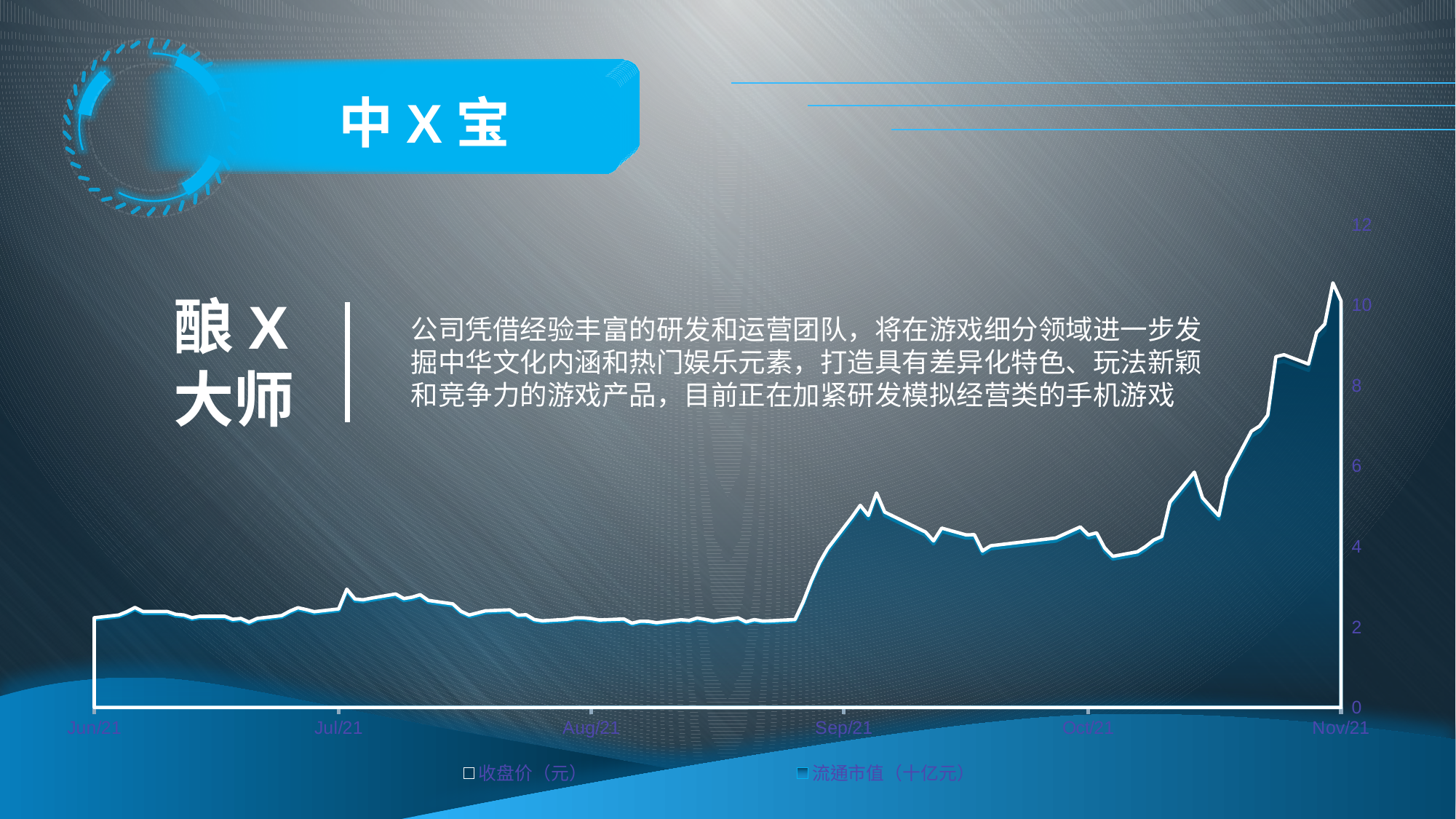
How many series does the chart legend list? 2 What is the highest tick value shown on the y axis? 12 Is the value at the start of the chart (Jun/21) greater or less than 4? less Is the value at Oct/21 greater or less than 6? less Near which x-axis label does the chart reach its highest value? Nov/21 Do the plotted values overall rise or fall from Jun/21 to Nov/21? rise What are the two series named in the chart legend? 收盘价（元） and 流通市值（十亿元） How many month labels are shown on the x axis? 6 What kind of chart is shown on the slide? area chart Is the value at Aug/21 greater or less than 4? less